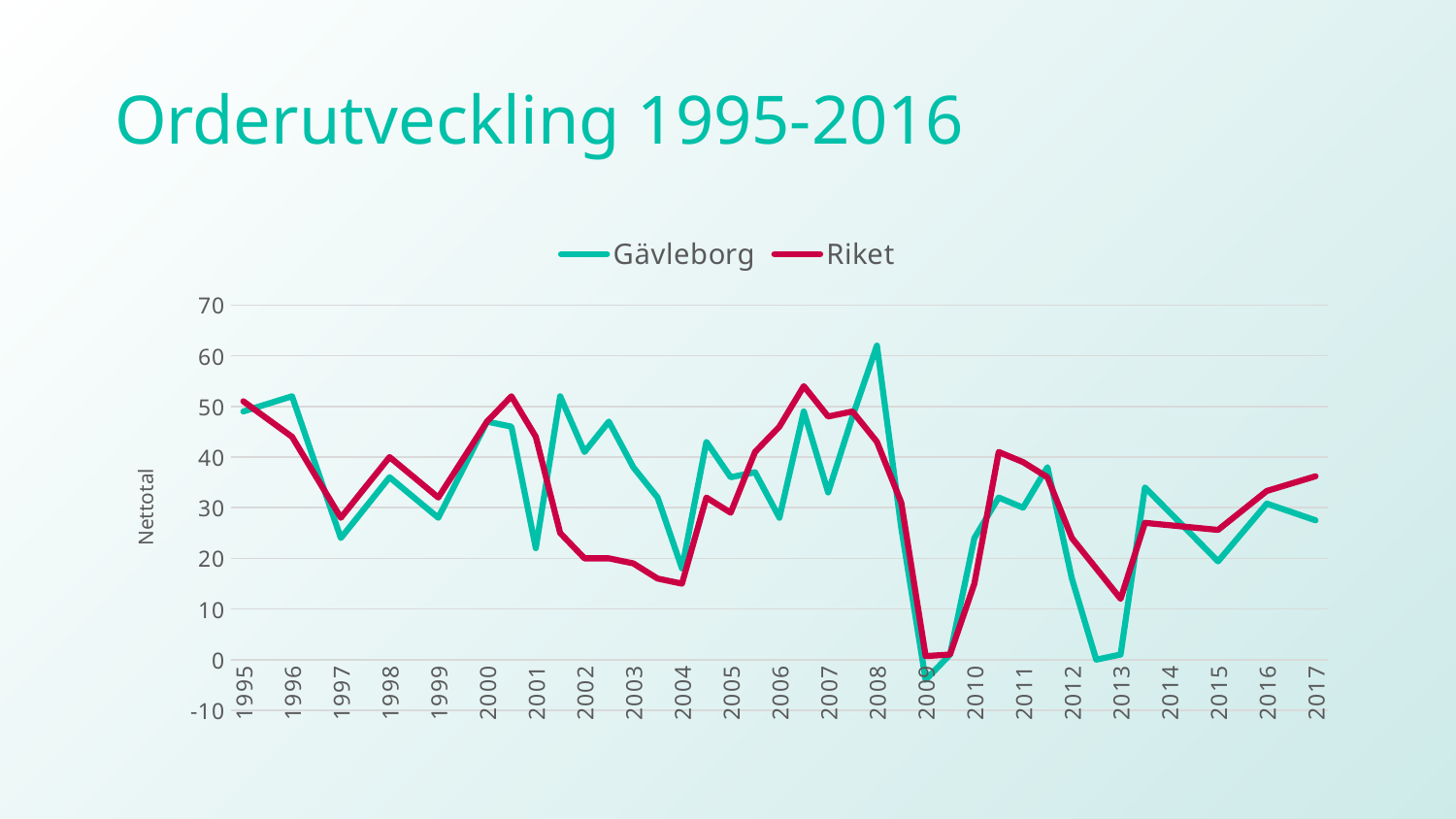
Is the value for Riket at 2017 greater or less than 30? greater How many series does the legend list? 2 Is the value for Gävleborg at 2013 greater or less than 10? less What kind of chart is shown on the slide? line chart Which series reaches the highest value anywhere on the chart? Gävleborg Do the values for Riket rise or fall between 2013 and 2017? rise What is the label on the vertical axis? Nettotal Is the peak value for Gävleborg around 2008 greater or less than 50? greater At 2017, which series has the higher value, Gävleborg or Riket? Riket What is the title of the chart? Orderutveckling 1995-2016